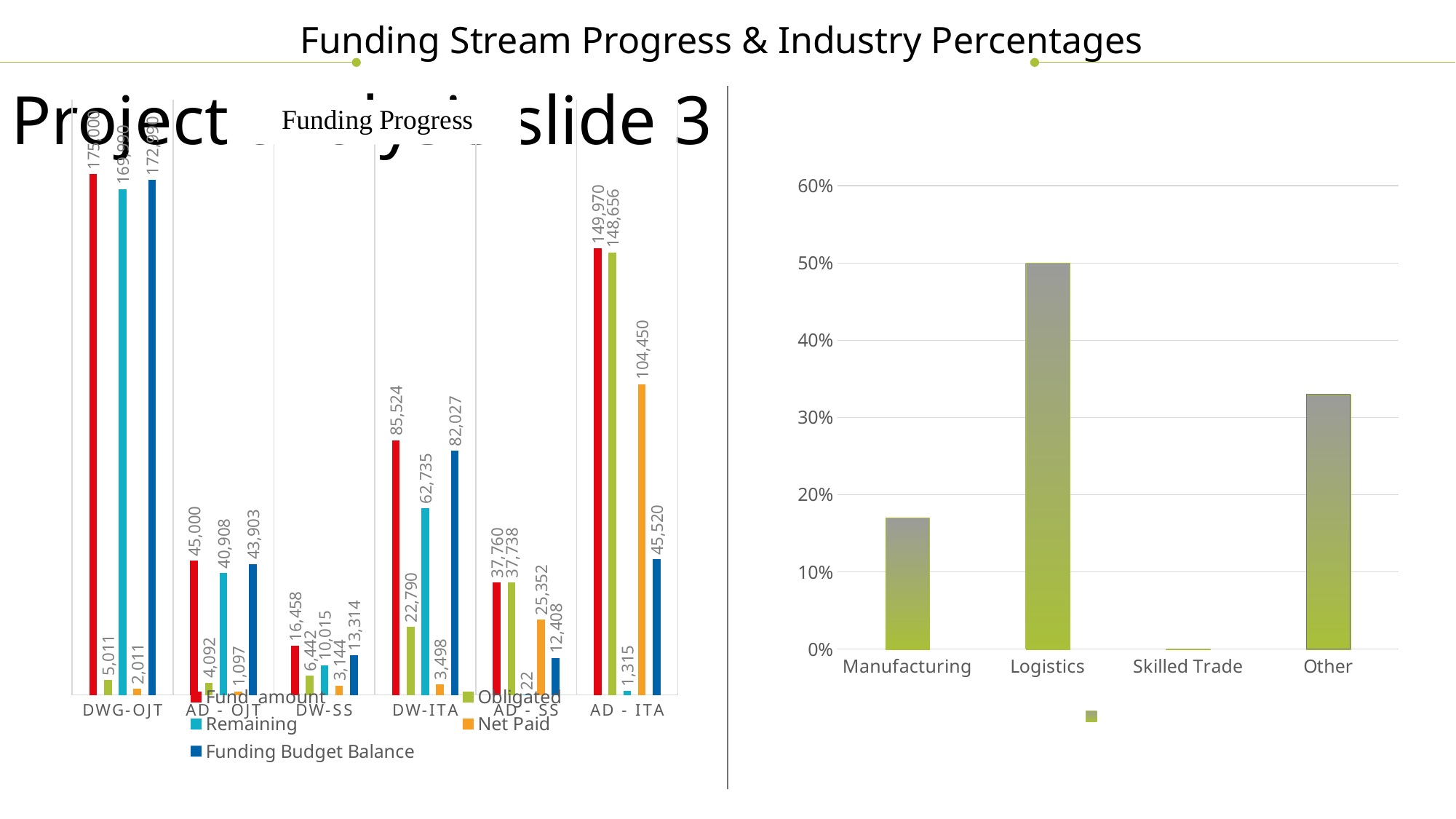
In the chart on the right, is the value for Manufacturing greater or less than 20%? less In the Funding Progress chart, which category has the lowest Fund amount? DW-SS In the Funding Progress chart, which is larger for AD - SS: Net Paid or Funding Budget Balance? Net Paid In the Funding Progress chart, what is the Remaining value for DW-ITA? 62,735 In the Funding Progress chart, what is the difference between the Fund amount and the Obligated value for DW-ITA? 62,734 In the Funding Progress chart, what is the Fund amount for AD - OJT? 45,000 In the Funding Progress chart, what is the Net Paid value for AD - ITA? 104,450 In the Funding Progress chart, what is the Obligated value for AD - SS? 37,738 In the chart on the right, what is the value for Logistics? 50% How many categories are shown on the x axis of the Funding Progress chart? 6 What kind of chart is the chart on the right of the slide? bar chart How many series does the legend of the Funding Progress chart list? 5